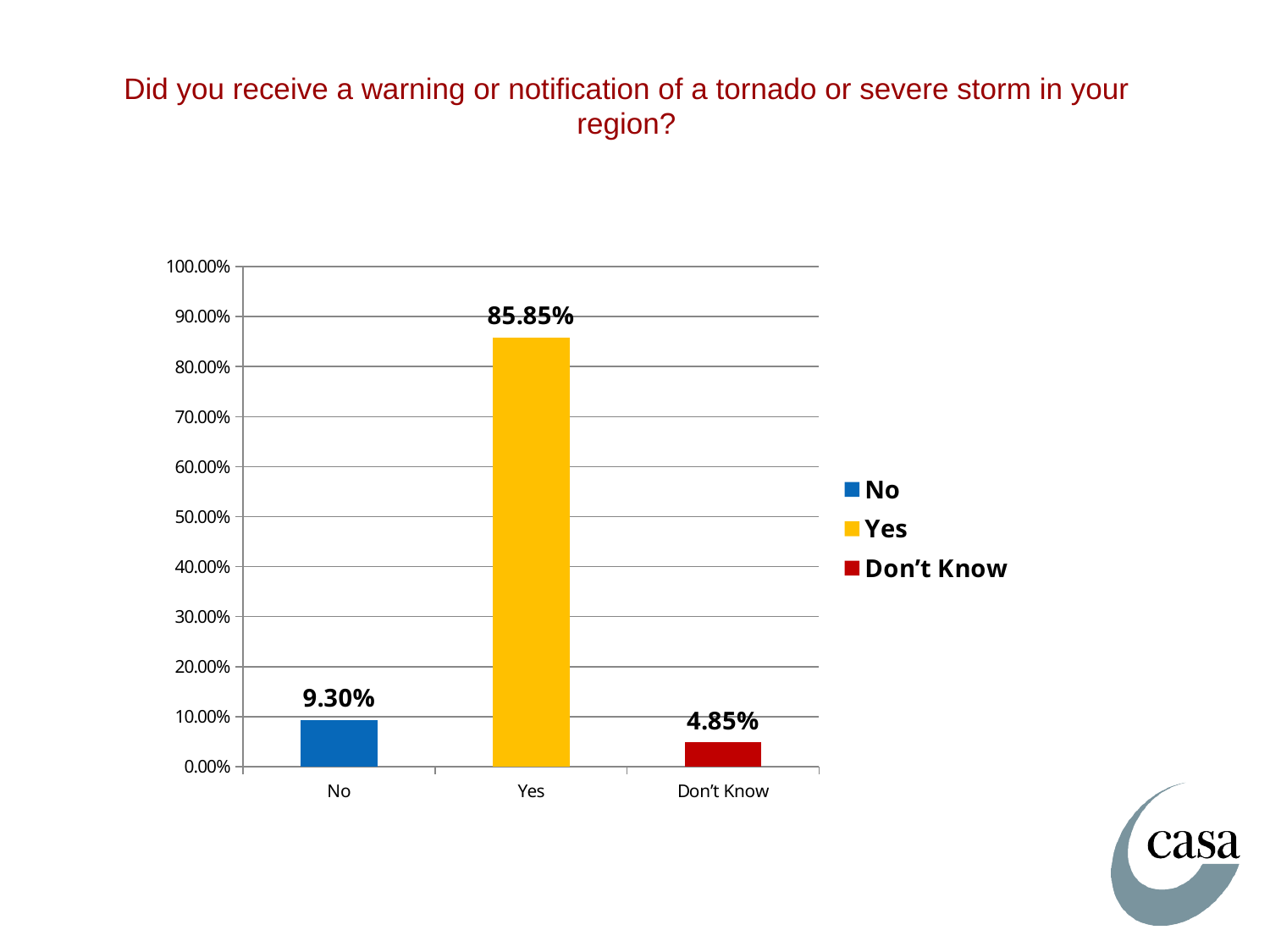
Which is larger, the percentage for "No" or for "Don't Know"? No What is the difference in percentage points between "Yes" and "No"? 76.55 What is the difference in percentage points between "No" and "Don't Know"? 4.45 How many entries does the legend list? 3 What percentage of respondents answered "No"? 9.30% Which response has the highest percentage? Yes What kind of chart is shown on the slide? Bar chart Which response has the lowest percentage? Don't Know How many response categories are shown on the x axis? 3 Is the value for "Yes" greater or less than 80.00%? greater What percentage of respondents answered "Yes"? 85.85% What percentage of respondents answered "Don't Know"? 4.85%